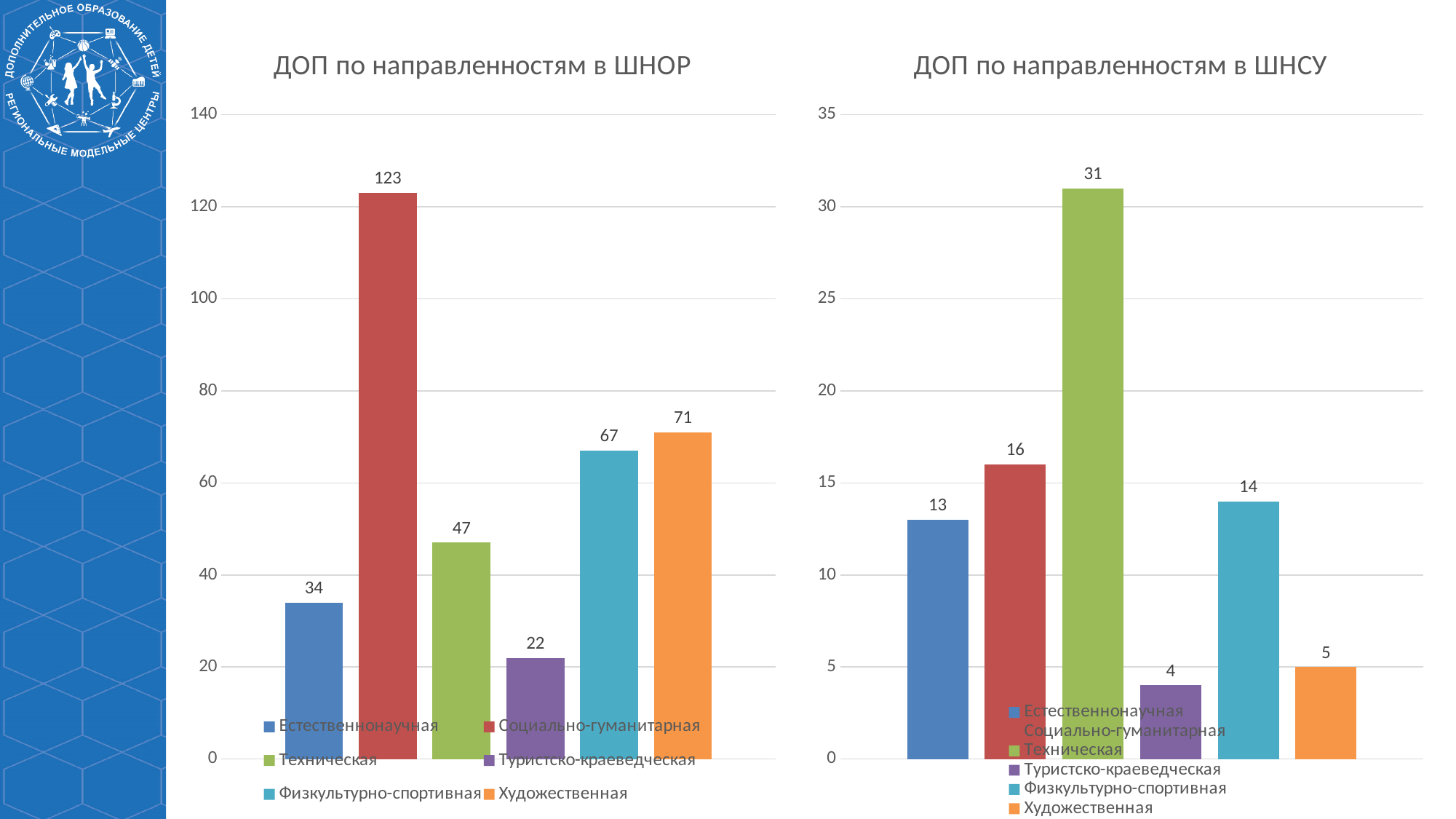
In the chart 'ДОП по направленностям в ШНОР', which category has the lowest value? Туристско-краеведческая In the chart 'ДОП по направленностям в ШНСУ', what is the value for Техническая? 31 In the chart 'ДОП по направленностям в ШНОР', is the value for Социально-гуманитарная greater or less than 100? greater In the chart 'ДОП по направленностям в ШНОР', what colour is the bar for Художественная? orange What type of chart is 'ДОП по направленностям в ШНОР'? bar chart In the chart 'ДОП по направленностям в ШНОР', what is the difference between Художественная and Физкультурно-спортивная? 4 In the chart 'ДОП по направленностям в ШНОР', which is larger: Естественнонаучная or Техническая? Техническая In the chart 'ДОП по направленностям в ШНСУ', which is larger: Туристско-краеведческая or Художественная? Художественная In the chart 'ДОП по направленностям в ШНСУ', what is the difference between Социально-гуманитарная and Естественнонаучная? 3 In the chart 'ДОП по направленностям в ШНСУ', which category has the highest value? Техническая In the chart 'ДОП по направленностям в ШНОР', what is the value for Социально-гуманитарная? 123 How many bars are plotted in the chart 'ДОП по направленностям в ШНСУ'? 6